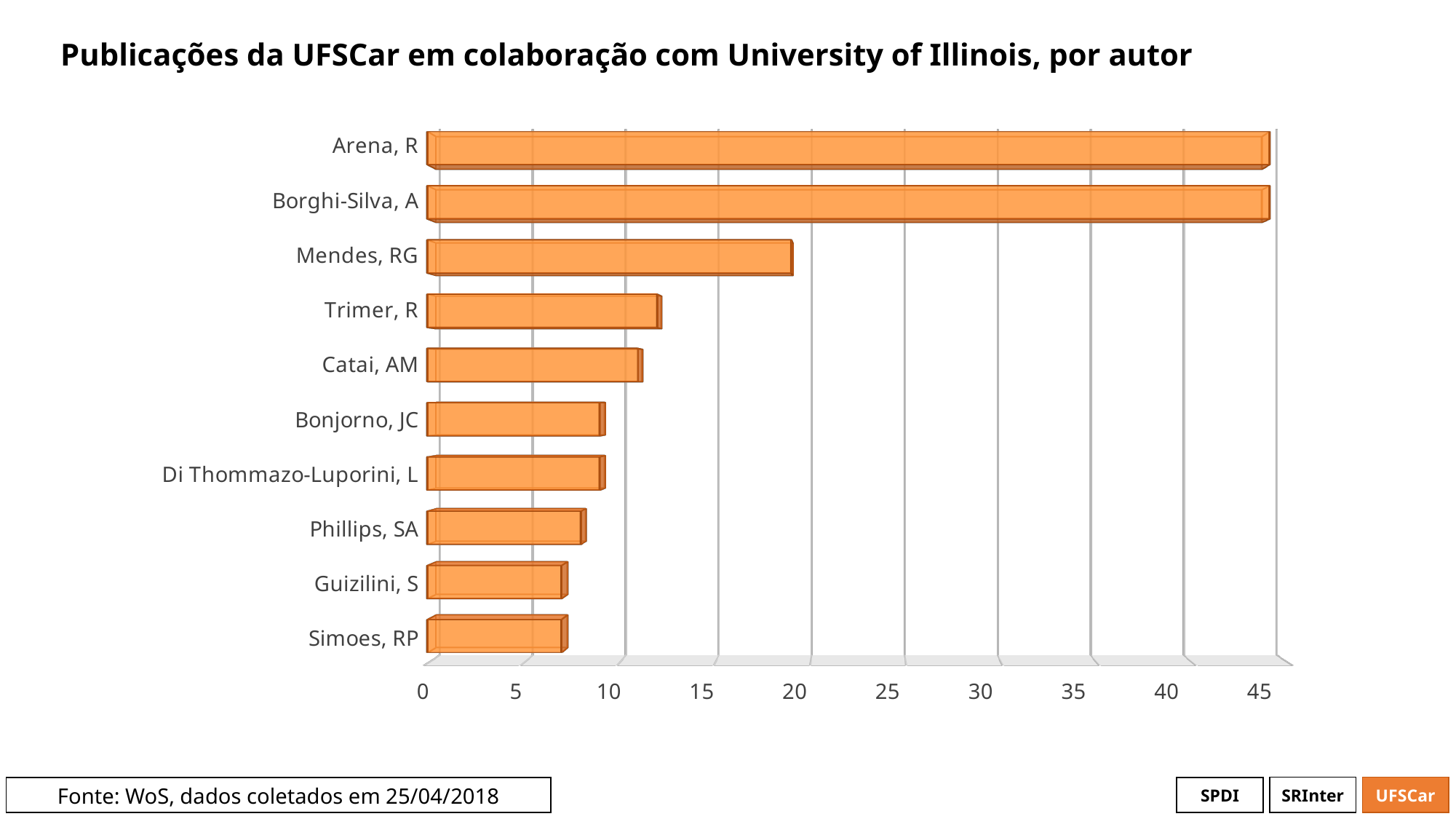
What kind of chart is shown on the slide? bar chart Is the value for Guizilini, S greater or less than 5? greater Which has a larger value, Mendes, RG or Trimer, R? Mendes, RG How many authors are listed in the chart? 10 Is the value for Mendes, RG greater or less than 15? greater Is the value for Phillips, SA greater or less than 10? less Which has a larger value, Catai, AM or Phillips, SA? Catai, AM What is the source of the data cited on the slide? WoS, dados coletados em 25/04/2018 What is the title of the chart? Publicações da UFSCar em colaboração com University of Illinois, por autor